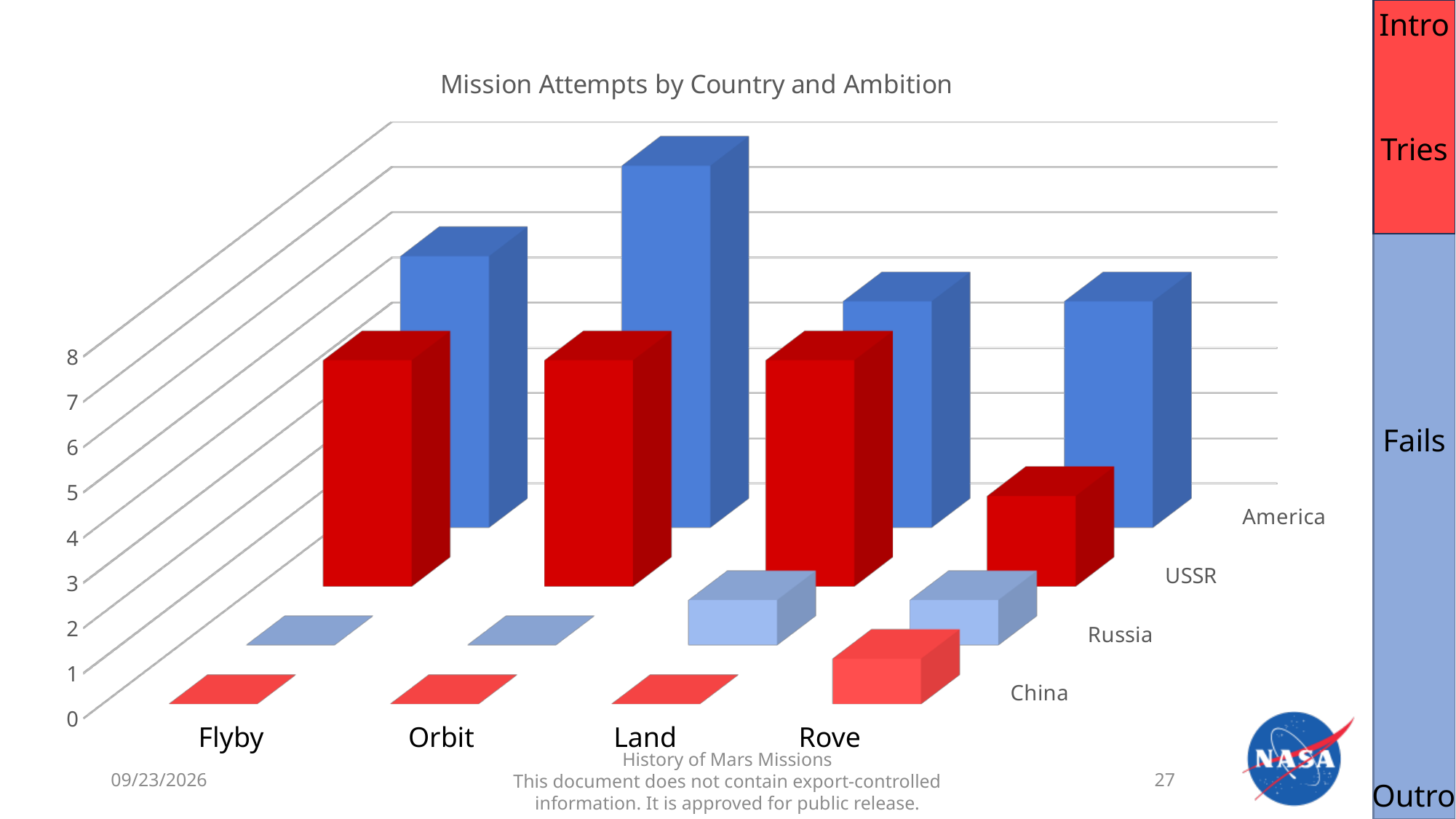
What is the title of the chart? Mission Attempts by Country and Ambition How many countries are plotted as series in the chart? 4 What is the value for China in the Flyby category? 0 What colour are the bars for America? blue For the USSR, which ambition category has the lowest bar? Rove What kind of chart is shown on the slide? bar chart How many mission ambition categories are shown along the x axis? 4 Is the value for America Orbit greater or less than 2? greater Is the value for USSR Rove greater or less than 8? less Which is larger for the USSR: the Flyby bar or the Rove bar? Flyby Which is larger for America: the Orbit bar or the Flyby bar? Orbit Which country and ambition combination has the tallest bar in the chart? America, Orbit